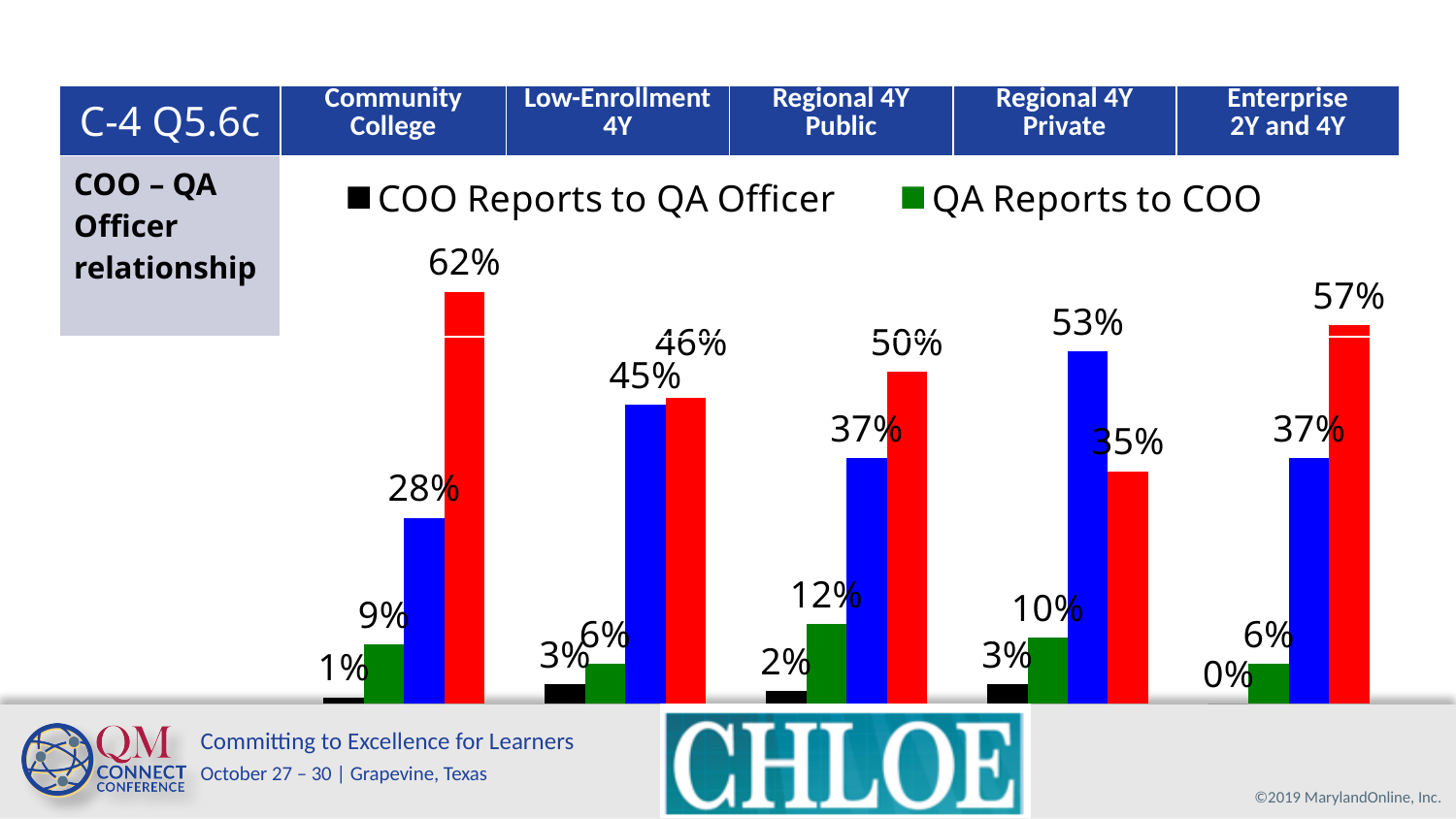
How many institution categories are shown along the x axis of the chart? 5 Which category has the lowest value for 'COO Reports to QA Officer'? Enterprise 2Y and 4Y What type of chart is shown on the slide? bar chart What is the value of 'COO Reports to QA Officer' for Enterprise 2Y and 4Y? 0% What is the difference between 'QA Reports to COO' and 'COO Reports to QA Officer' for Regional 4Y Public? 10% Which category has the highest value for 'QA Reports to COO'? Regional 4Y Public What is the value of 'QA Reports to COO' for Regional 4Y Private? 10% How many series does the visible legend list? 2 Which is larger for Low-Enrollment 4Y: 'COO Reports to QA Officer' or 'QA Reports to COO'? QA Reports to COO What is the highest data label shown anywhere on the chart? 62% What is the value of 'QA Reports to COO' for Community College? 9% What is the value of 'COO Reports to QA Officer' for Regional 4Y Public? 2%